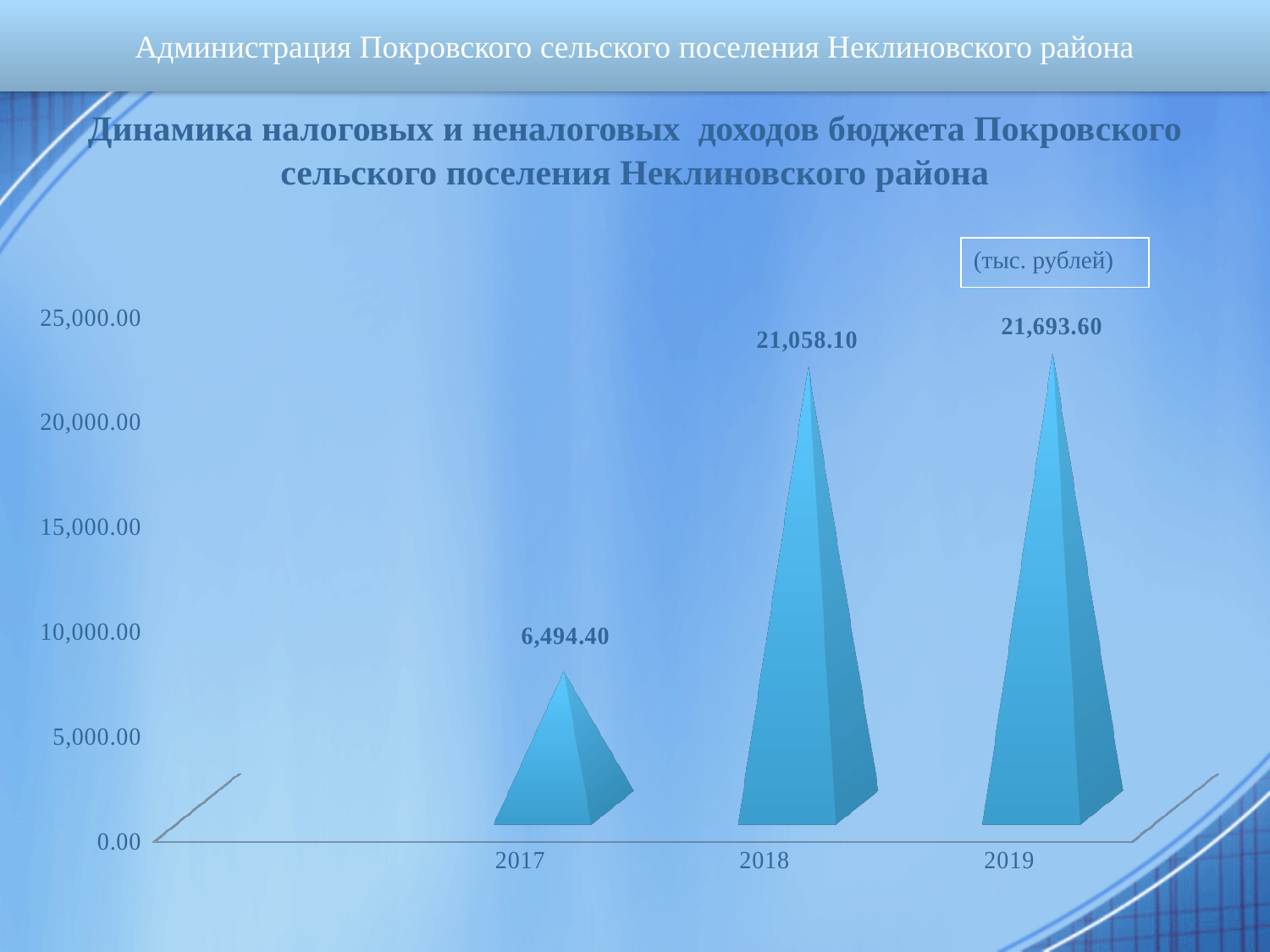
Is the value for 2017 greater or less than 10,000.00? less What kind of chart is shown on the slide? bar chart Which is larger, the value for 2017 or the value for 2018? 2018 What is the difference between the values for 2019 and 2018? 635.50 Which year has the lowest value? 2017 What is the value for 2017? 6,494.40 Do the values rise or fall from 2017 to 2019? rise What is the value for 2018? 21,058.10 What is the difference between the values for 2018 and 2017? 14,563.70 Which year has the highest value? 2019 What is the value for 2019? 21,693.60 How many years are shown on the x axis? 3